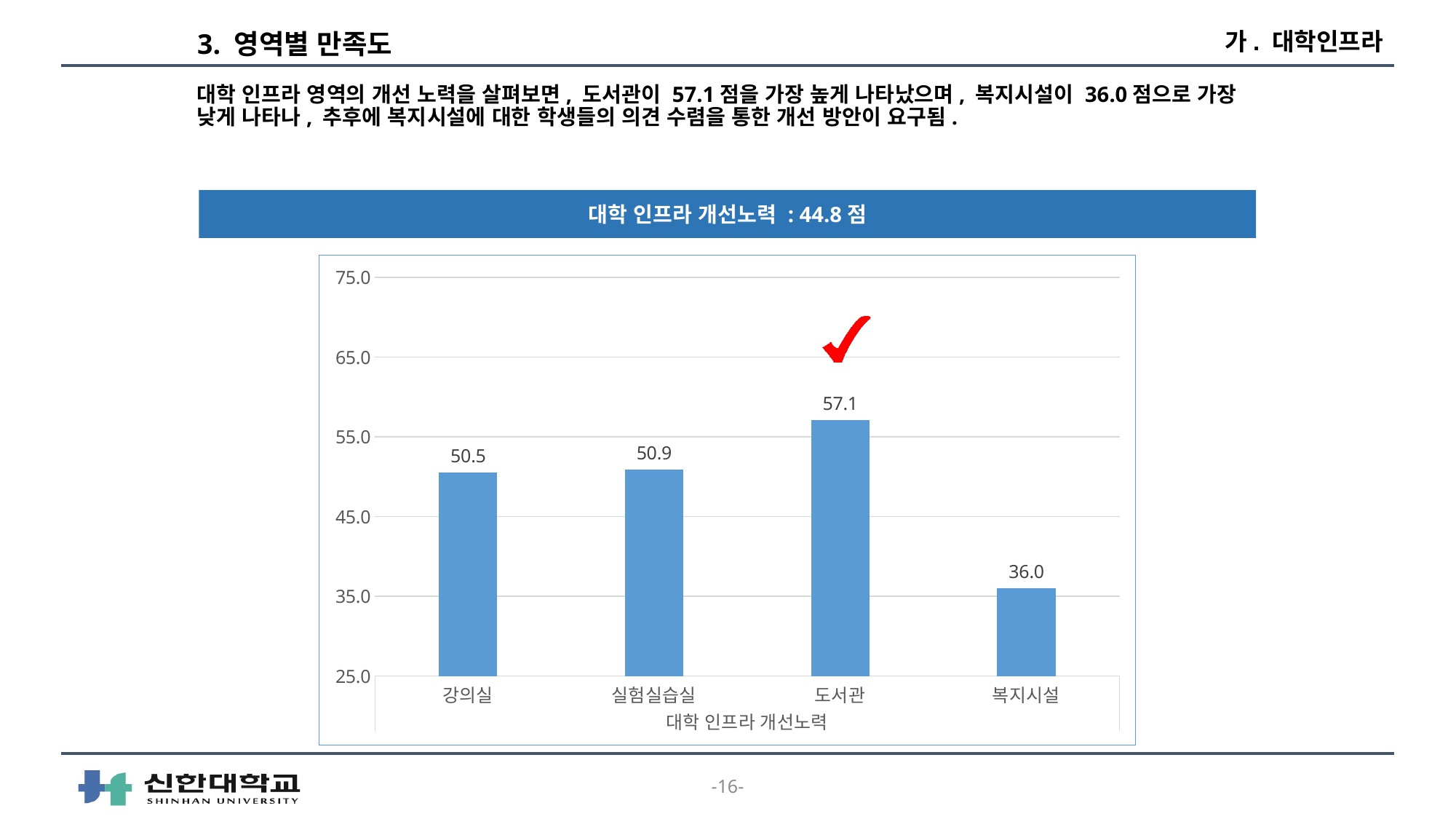
What is the value for 복지시설? 36.0 Is the value for 복지시설 greater or less than 45.0? less How many categories are shown on the x axis? 4 Which category has the highest value? 도서관 What is the value for 강의실? 50.5 Which category has the lowest value? 복지시설 What is the value for 실험실습실? 50.9 Which is larger, the value for 도서관 or the value for 강의실? 도서관 What is the x-axis title of the chart? 대학 인프라 개선노력 What kind of chart is shown on the slide? bar chart What is the difference between the values for 도서관 and 복지시설? 21.1 What is the value for 도서관? 57.1